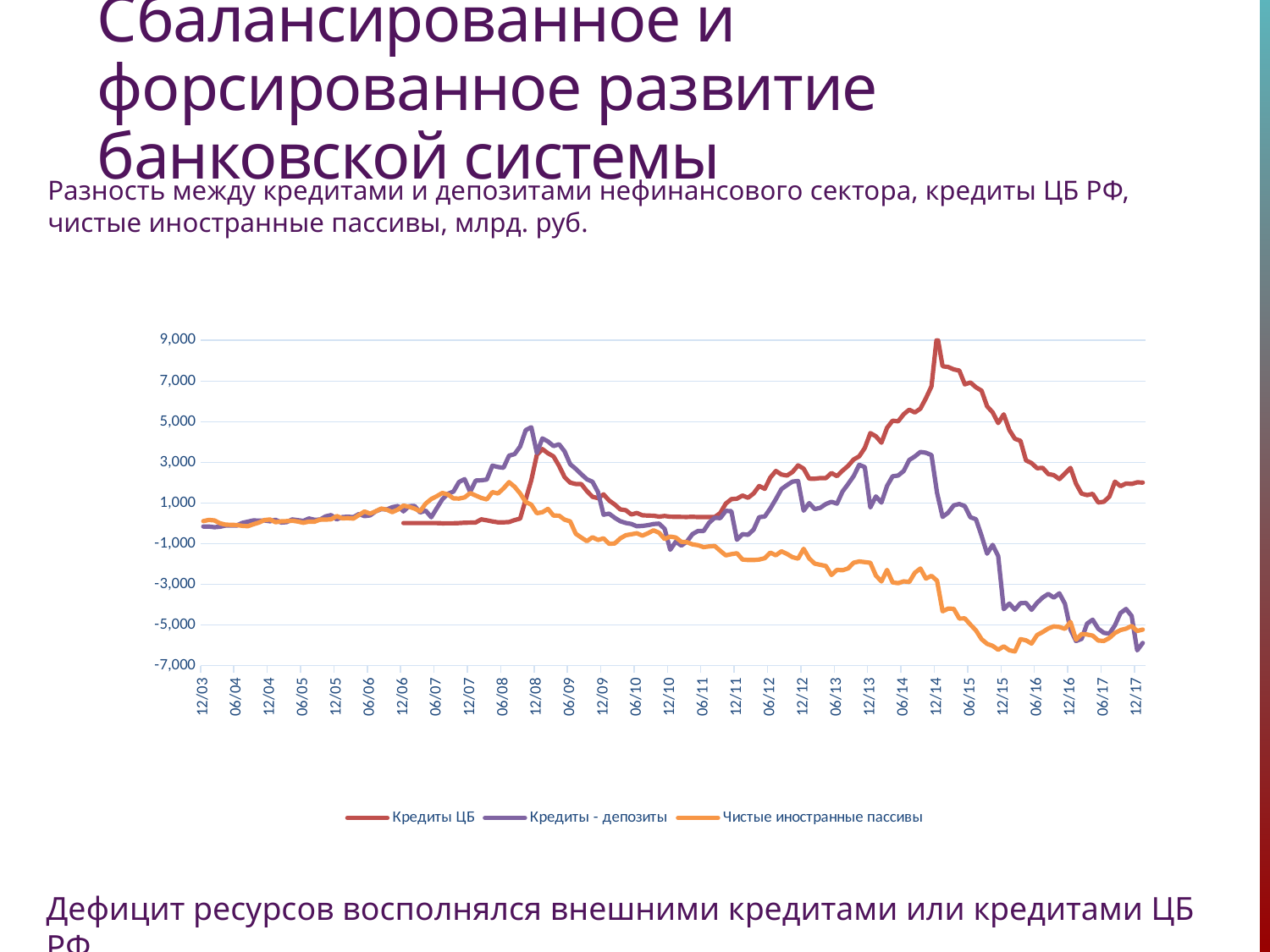
What is the highest value shown on the chart's vertical axis? 9,000 Does the Кредиты ЦБ series rise or fall between 12/14 and 12/16? fall Is the value of Кредиты ЦБ at 12/14 greater or less than 7,000? greater What kind of chart is shown on the slide? line chart Does the Чистые иностранные пассивы series rise or fall between 06/08 and 12/15? fall How many series does the chart legend list? 3 Is the value of Кредиты - депозиты at 12/17 greater or less than -5,000? less Is the value of Чистые иностранные пассивы at 12/15 greater or less than -5,000? less Which series reaches the highest value anywhere on the chart? Кредиты ЦБ At 12/14, which is larger: Кредиты ЦБ or Чистые иностранные пассивы? Кредиты ЦБ At 12/17, which is larger: Кредиты ЦБ or Кредиты - депозиты? Кредиты ЦБ